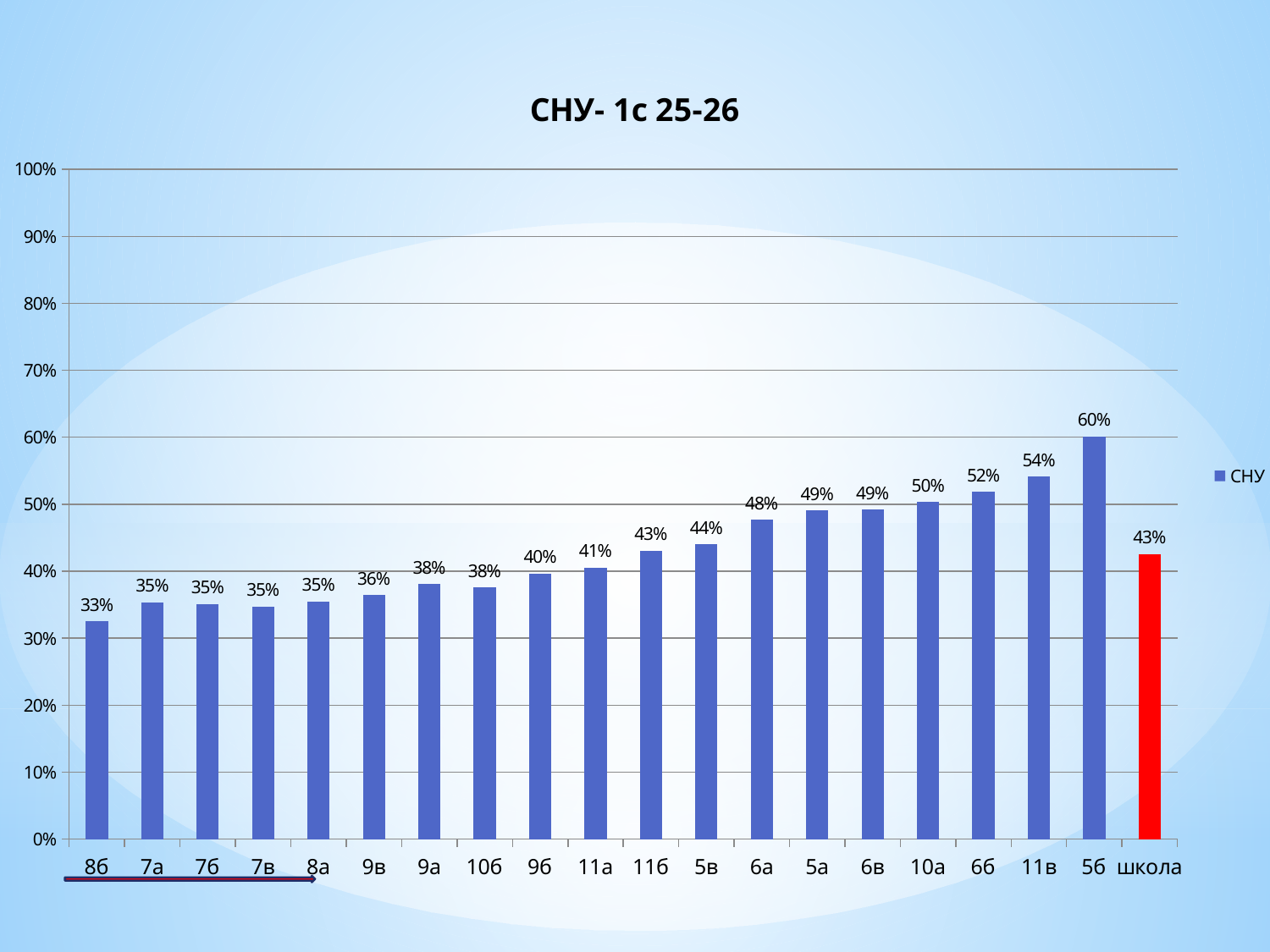
Which category has the lowest value? 8б What is the difference between the values for 5б and 8б? 27 percentage points What kind of chart is shown on the slide? Bar chart What is the value for школа? 43% What is the value for 11а? 41% Which category is drawn with a red bar? школа How many series does the legend list? 1 Which category has the highest value? 5б What is the value for 5б? 60% How many categories are shown on the x axis? 20 Is the value for 10а greater or less than 40%? greater Which is larger, the value for 6б or the value for 9б? 6б